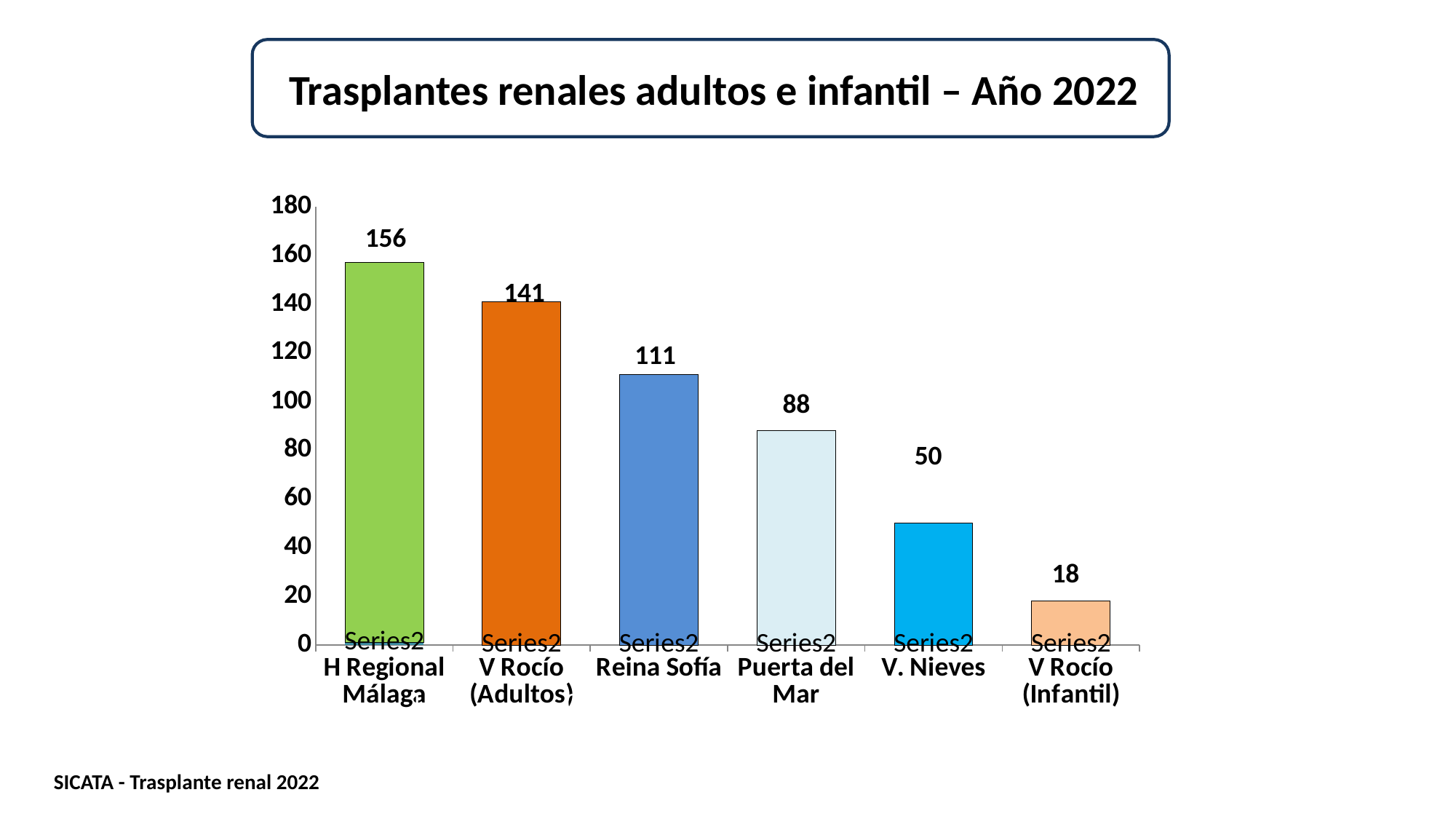
What kind of chart is shown on the slide? Bar chart What is the value for V Rocío (Infantil)? 18 What is the value for Puerta del Mar? 88 Which is larger, the value for Reina Sofía or the value for Puerta del Mar? Reina Sofía Which category has the lowest value? V Rocío (Infantil) What is the value for H Regional Málaga? 156 Which category has the highest value? H Regional Málaga What is the value for Reina Sofía? 111 How many categories are shown on the chart? 6 What is the title of the chart? Trasplantes renales adultos e infantil – Año 2022 What is the value for V Rocío (Adultos)? 141 What is the difference between the values for H Regional Málaga and V Rocío (Adultos)? 15